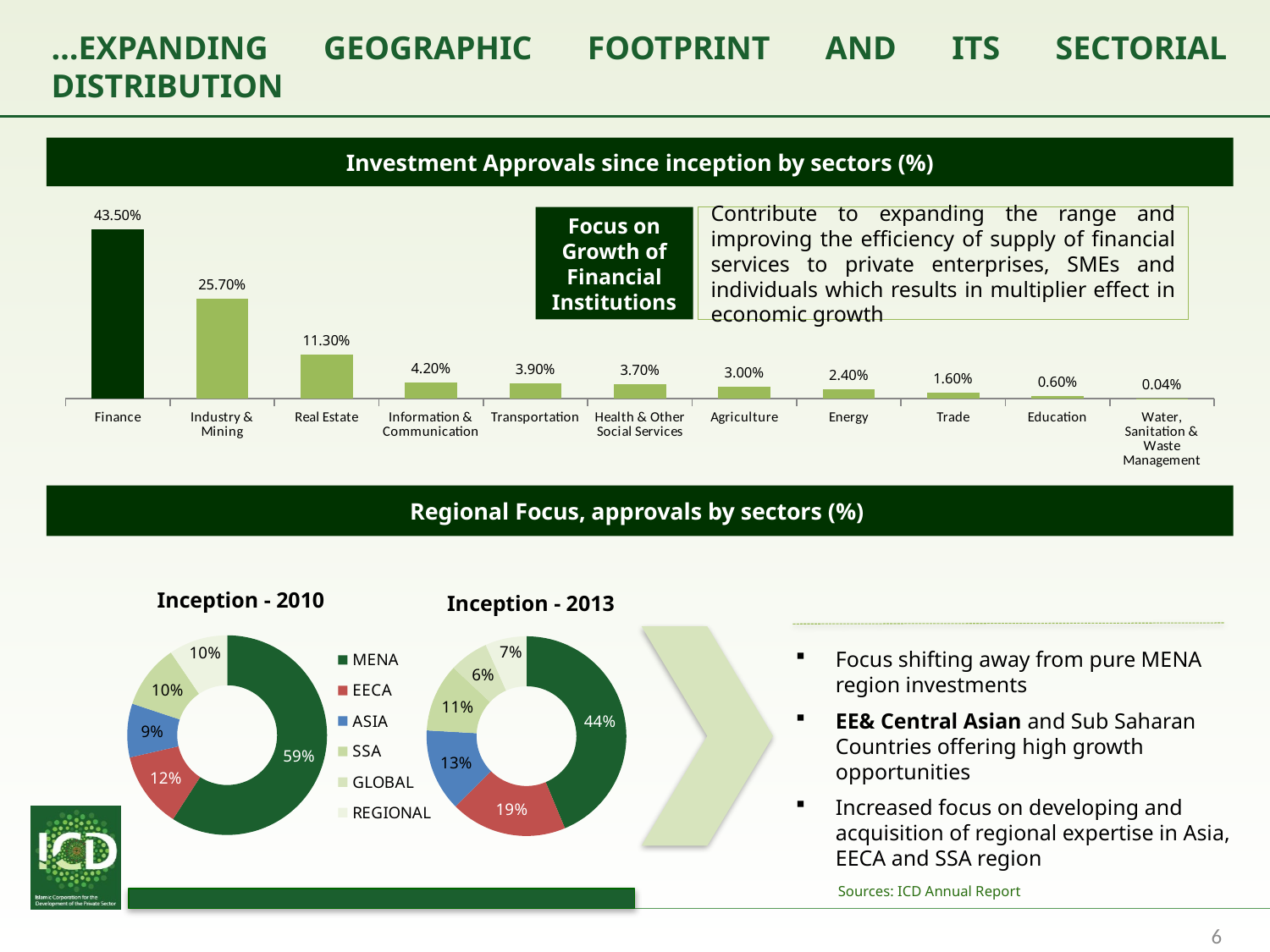
In the 'Investment Approvals since inception by sectors (%)' chart, what is the difference between Finance and Industry & Mining? 17.80% In the 'Investment Approvals since inception by sectors (%)' chart, how many sectors are shown? 11 In the 'Investment Approvals since inception by sectors (%)' chart, what is the value for Real Estate? 11.30% What type of chart is 'Investment Approvals since inception by sectors (%)'? Bar chart How many entries does the legend of the 'Inception - 2010' and 'Inception - 2013' charts list? 6 In the 'Inception - 2010' chart, what share does MENA have? 59% In the 'Investment Approvals since inception by sectors (%)' chart, what is the value for Finance? 43.50% Which is larger: the MENA share in 'Inception - 2010' or in 'Inception - 2013'? Inception - 2010 In the 'Investment Approvals since inception by sectors (%)' chart, which is larger: Transportation or Agriculture? Transportation In the 'Inception - 2013' chart, what share does EECA have? 19% In the 'Investment Approvals since inception by sectors (%)' chart, which sector has the highest value? Finance In the 'Investment Approvals since inception by sectors (%)' chart, which sector has the lowest value? Water, Sanitation & Waste Management